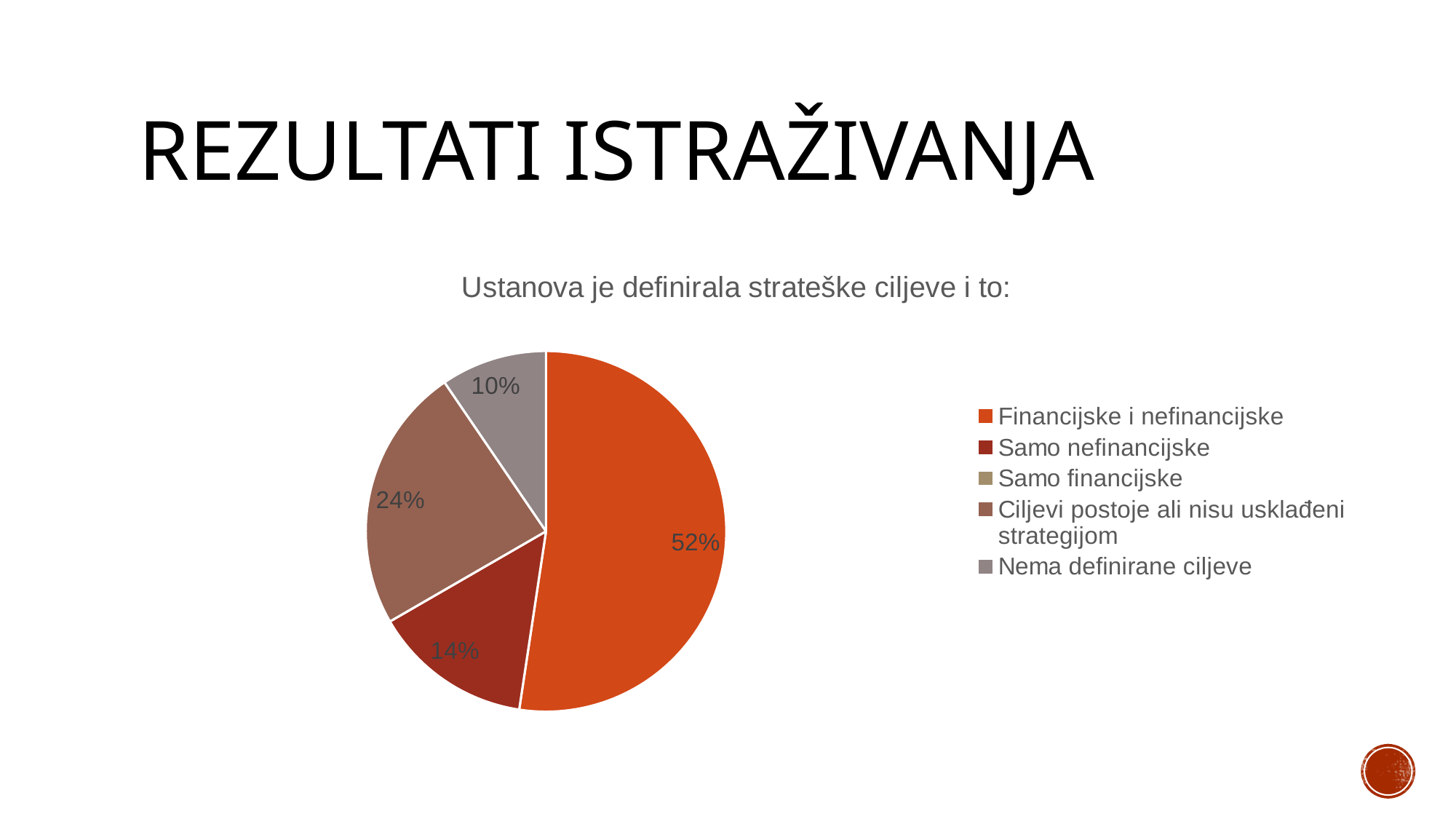
Which slice is larger: 'Samo nefinancijske' or 'Nema definirane ciljeve'? Samo nefinancijske What share of the pie is labelled for 'Nema definirane ciljeve'? 10% Which labelled slice of the pie is the smallest? Nema definirane ciljeve What colour is the 'Financijske i nefinancijske' slice? orange How many entries does the legend of the pie chart list? 5 What share of the pie is labelled for 'Financijske i nefinancijske'? 52% Which category has the largest slice of the pie? Financijske i nefinancijske What kind of chart is shown on the slide? pie chart What share of the pie is labelled for 'Ciljevi postoje ali nisu usklađeni strategijom'? 24% What is the title of the pie chart? Ustanova je definirala strateške ciljeve i to: What share of the pie is labelled for 'Samo nefinancijske'? 14% What is the difference in percentage points between the 'Financijske i nefinancijske' slice and the 'Ciljevi postoje ali nisu usklađeni strategijom' slice? 28 percentage points